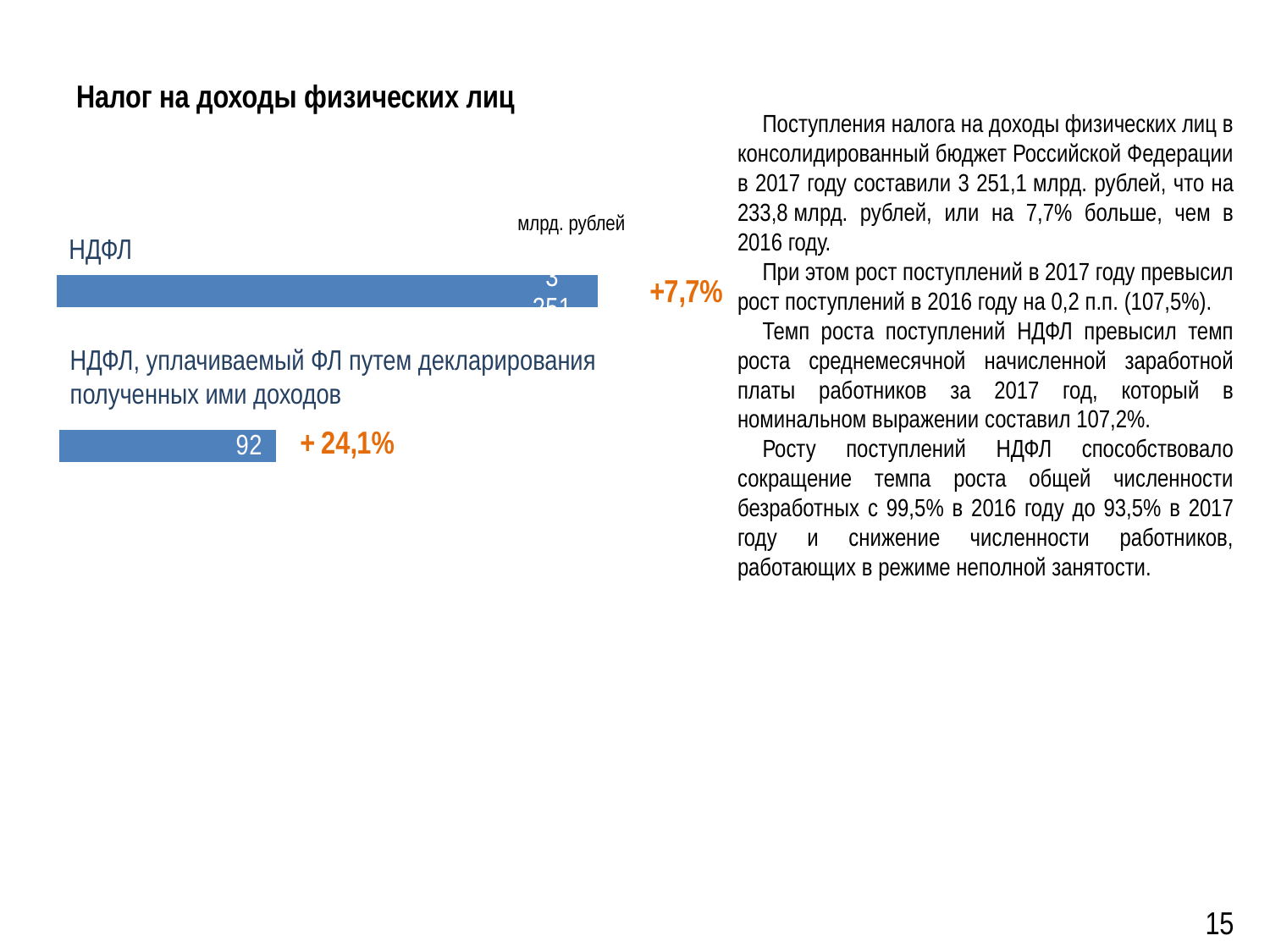
What kind of chart is shown on the slide? Bar chart What is the title of the slide containing the chart? Налог на доходы физических лиц Which category has the highest value in the chart? НДФЛ Which bar is longer: «НДФЛ» or «НДФЛ, уплачиваемый ФЛ путем декларирования полученных ими доходов»? НДФЛ How many bars are shown in the chart? 2 What growth percentage is shown next to the «НДФЛ» bar? +7,7% Which category has the lowest value in the chart? НДФЛ, уплачиваемый ФЛ путем декларирования полученных ими доходов What value is printed on the bar for «НДФЛ, уплачиваемый ФЛ путем декларирования полученных ими доходов»? 92 What growth percentage is shown next to the bar for «НДФЛ, уплачиваемый ФЛ путем декларирования полученных ими доходов»? + 24,1% Which category shows the larger growth percentage: «НДФЛ» (+7,7%) or «НДФЛ, уплачиваемый ФЛ путем декларирования полученных ими доходов» (+ 24,1%)? НДФЛ, уплачиваемый ФЛ путем декларирования полученных ими доходов In what units are the chart values given? млрд. рублей